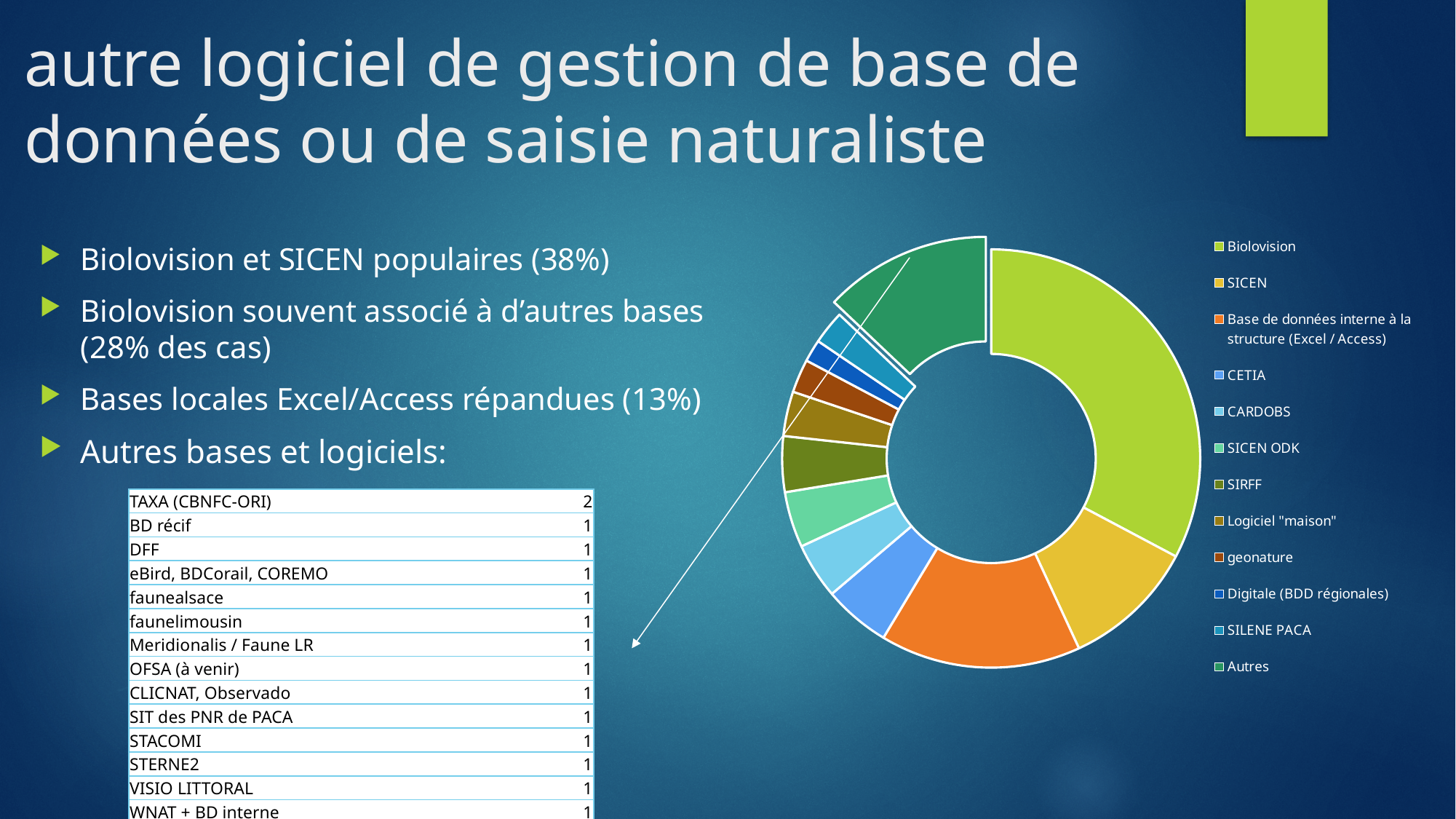
Which slice is larger in the doughnut chart, Biolovision or SICEN? Biolovision What kind of chart is shown on the slide? doughnut chart Which category is shown in orange in the doughnut chart? Base de données interne à la structure (Excel / Access) Which legend entry is listed last in the chart's legend? Autres Which category has the largest slice in the doughnut chart? Biolovision Which slice is larger, SICEN or CARDOBS? SICEN How many categories does the chart's legend list? 12 Which slice is larger, Autres or SIRFF? Autres